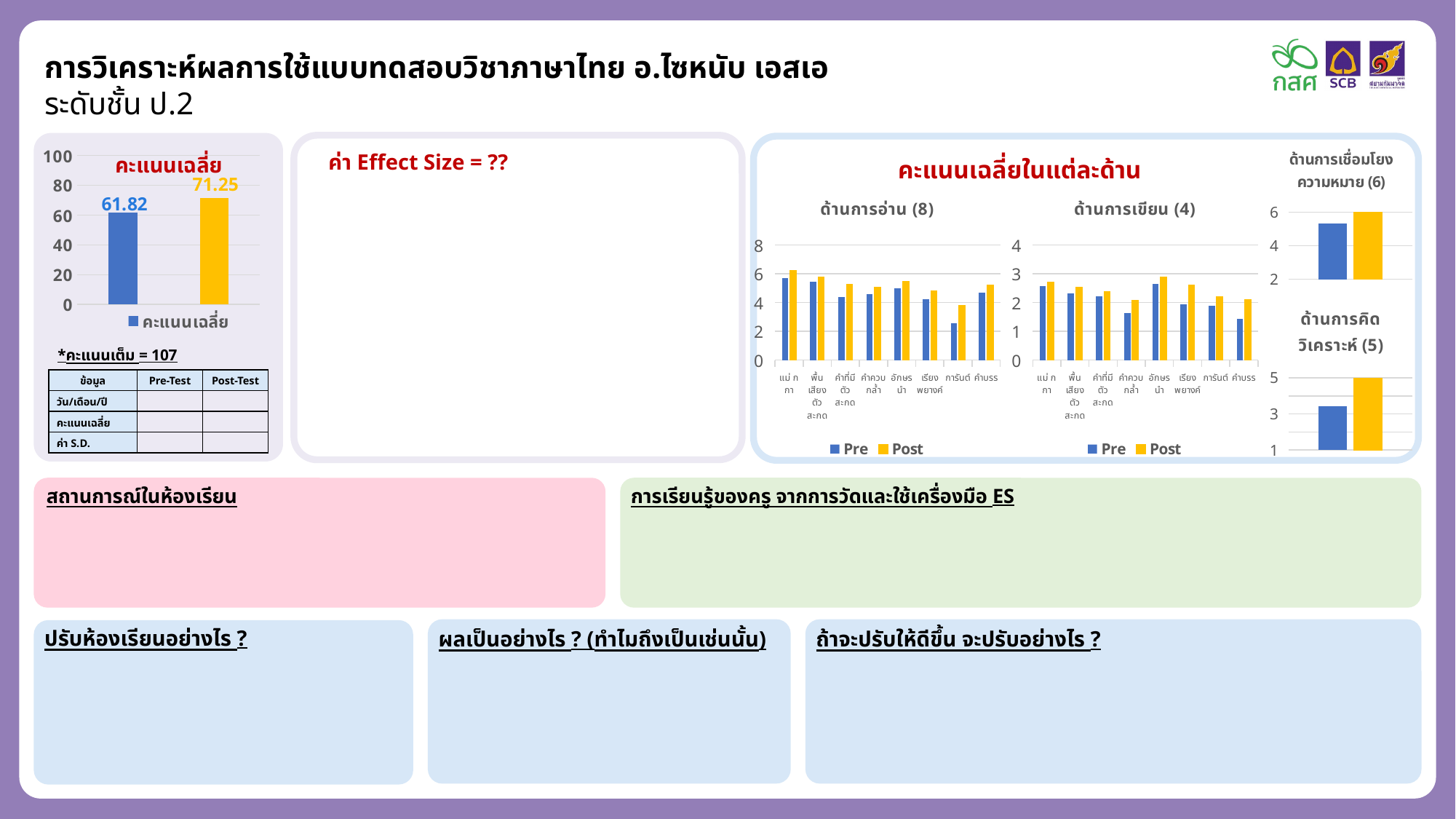
In the "ด้านการอ่าน (8)" chart, is the Pre value for การันต์ greater or less than 4? less What kind of chart is the "คะแนนเฉลี่ย" chart on the left? bar chart In the "ด้านการอ่าน (8)" chart, how many series does the legend list? 2 In the "ด้านการอ่าน (8)" chart, what are the legend entries? Pre and Post In the "ด้านการอ่าน (8)" chart, how many categories are shown on the x axis? 8 In the "คะแนนเฉลี่ย" chart on the left, what is the difference between the yellow bar and the blue bar? 9.43 In the "คะแนนเฉลี่ย" chart on the left, what is the value of the blue bar? 61.82 In the "คะแนนเฉลี่ย" chart on the left, what is the value of the yellow bar? 71.25 In the "คะแนนเฉลี่ย" chart on the left, which bar is higher, the blue one or the yellow one? the yellow one (71.25) In the "ด้านการเขียน (4)" chart, is the Post value for อักษรนำ greater or less than 2? greater In the "ด้านการเชื่อมโยงความหมาย (6)" chart, which bar is higher, Pre (blue) or Post (yellow)? Post (yellow) In the "ด้านการคิดวิเคราะห์ (5)" chart, is the Post (yellow) value greater or less than 4? greater